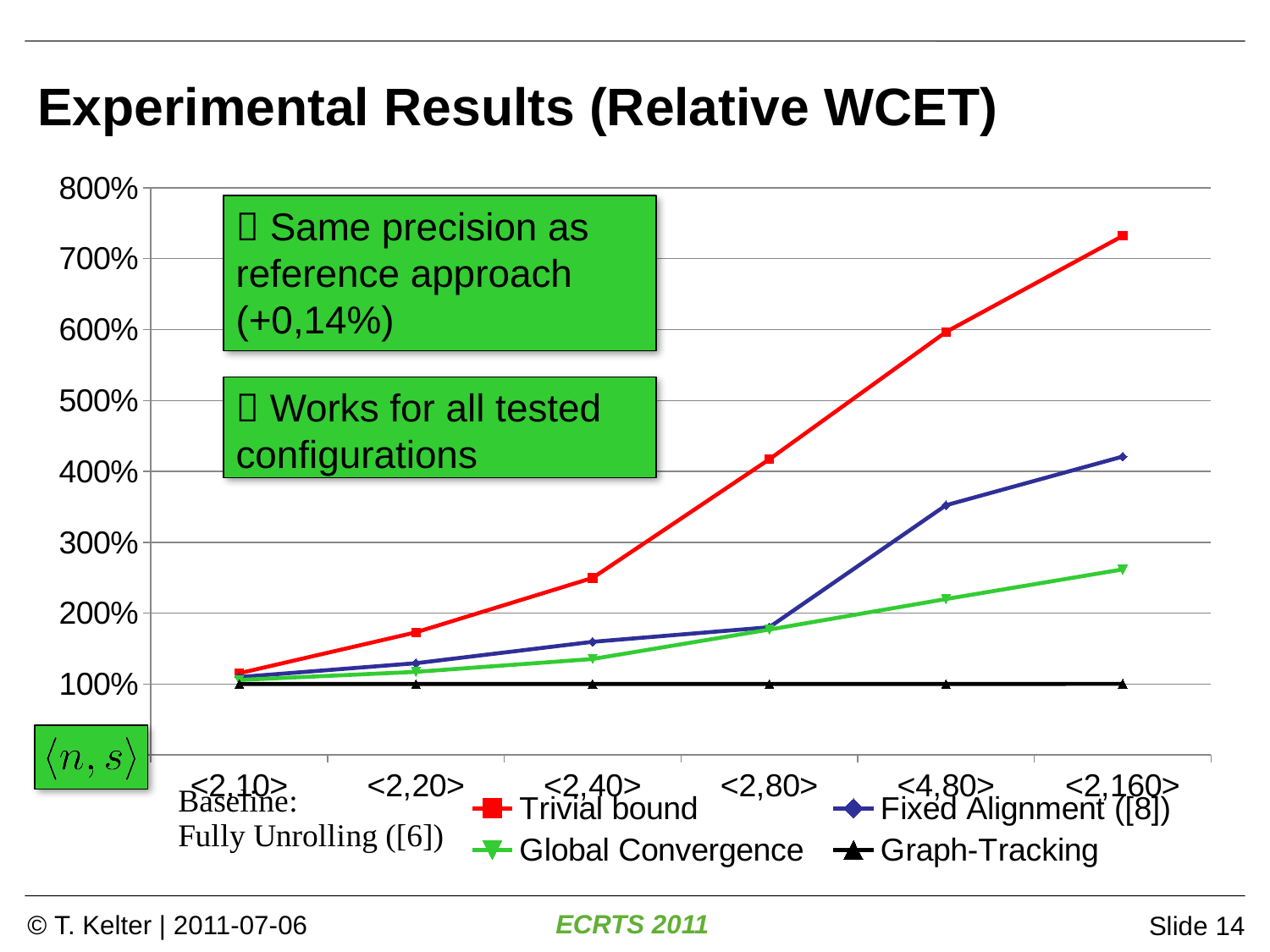
At <4,80>, which is larger: Fixed Alignment ([8]) or Global Convergence? Fixed Alignment ([8]) What is the value of Graph-Tracking at <2,80>? 100% What is the title of the slide containing the chart? Experimental Results (Relative WCET) How many series does the legend list? 4 Is the value for Fixed Alignment ([8]) at <4,80> greater or less than 300%? greater Is the value for Trivial bound at <2,160> greater or less than 700%? greater What kind of chart is shown on the slide? line chart Which series has the lowest value at <2,160>? Graph-Tracking Which series has the highest value at <2,160>? Trivial bound Is the value for Global Convergence at <2,160> greater or less than 300%? less Does the Trivial bound series rise or fall from <2,10> to <2,160>? rise How many configurations are shown along the x axis? 6